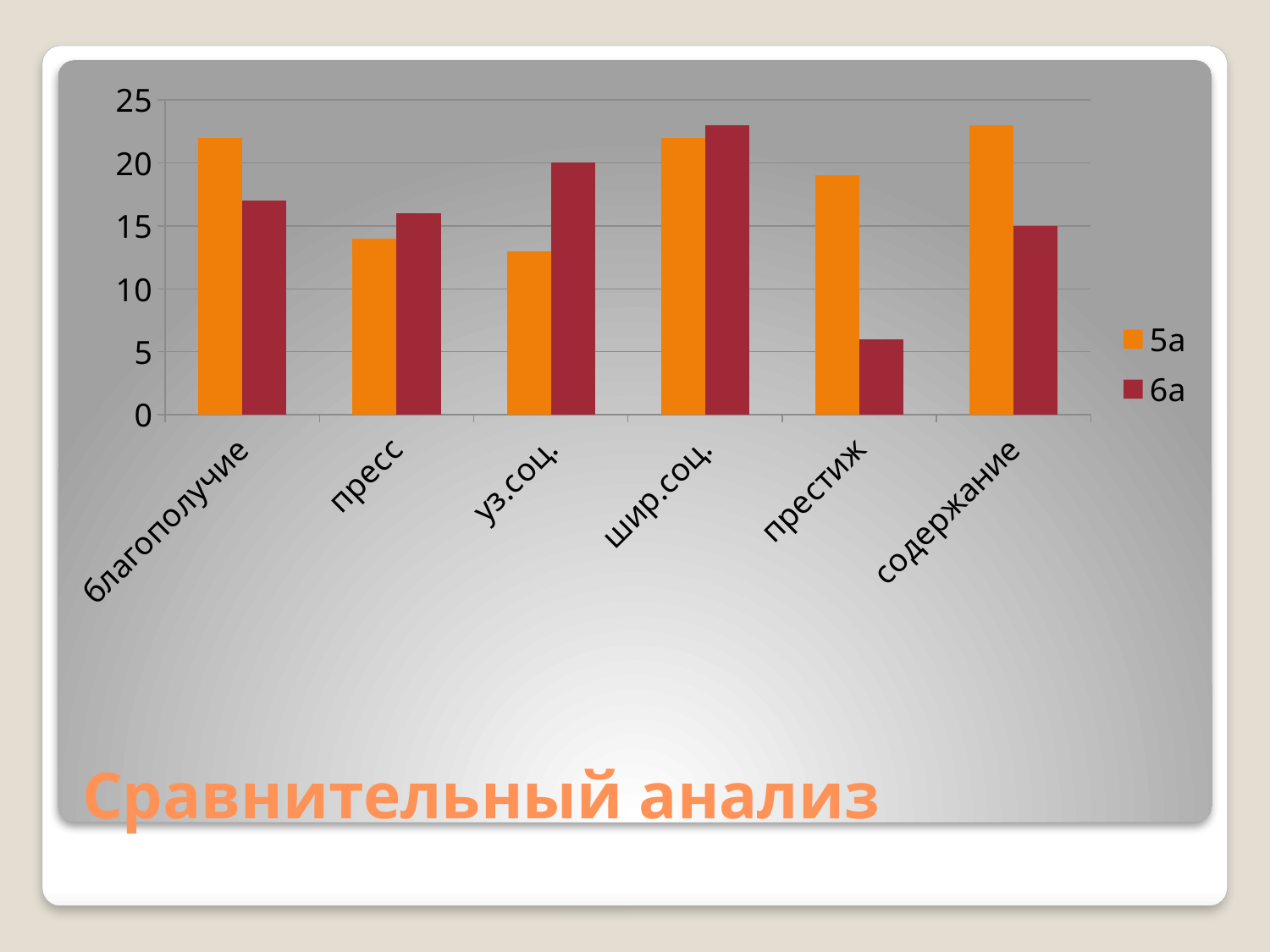
For which category is the 6а value the lowest? престиж What is the title of the slide? Сравнительный анализ What kind of chart is shown on the slide? bar chart Is the value for 5а in благополучие greater or less than 20? greater Is the value for 6а in престиж greater or less than 10? less For which category is the 6а value the highest? шир.соц. In уз.соц., which series has the larger value, 5а or 6а? 6а How many categories are shown on the x axis? 6 How many series does the legend list? 2 Is the value for 6а in шир.соц. greater or less than 20? greater Which series is shown in orange? 5а